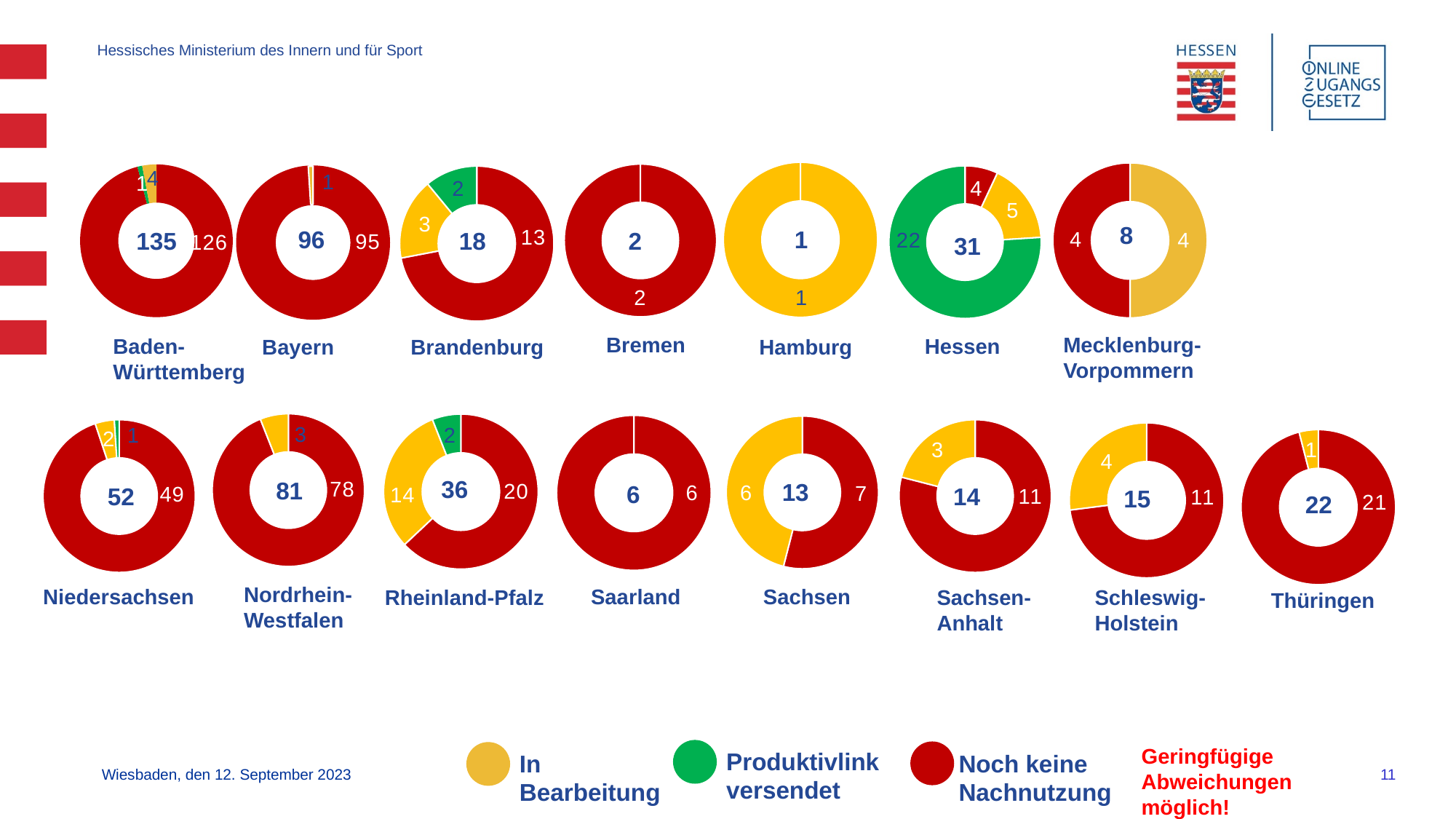
What kind of chart is used for each state? Donut (pie) chart What is the total shown in the centre of the Hessen chart? 31 What is the difference between the centre totals of Bayern and Nordrhein-Westfalen? 15 In the Sachsen chart, which segment is larger: 'In Bearbeitung' or 'Noch keine Nachnutzung'? Noch keine Nachnutzung How many state charts are shown on the slide? 15 In the Rheinland-Pfalz chart, what is the value of the 'In Bearbeitung' (yellow) segment? 14 How many categories does the legend list? 3 In the Brandenburg chart, what is the value of the 'Noch keine Nachnutzung' (red) segment? 13 Which state's chart shows the lowest total in its centre? Hamburg In the Mecklenburg-Vorpommern chart, what share of the total is 'Noch keine Nachnutzung' (red)? 50% Which state's chart shows the highest total in its centre? Baden-Württemberg In the Hessen chart, how many are labelled as 'Produktivlink versendet' (green)? 22